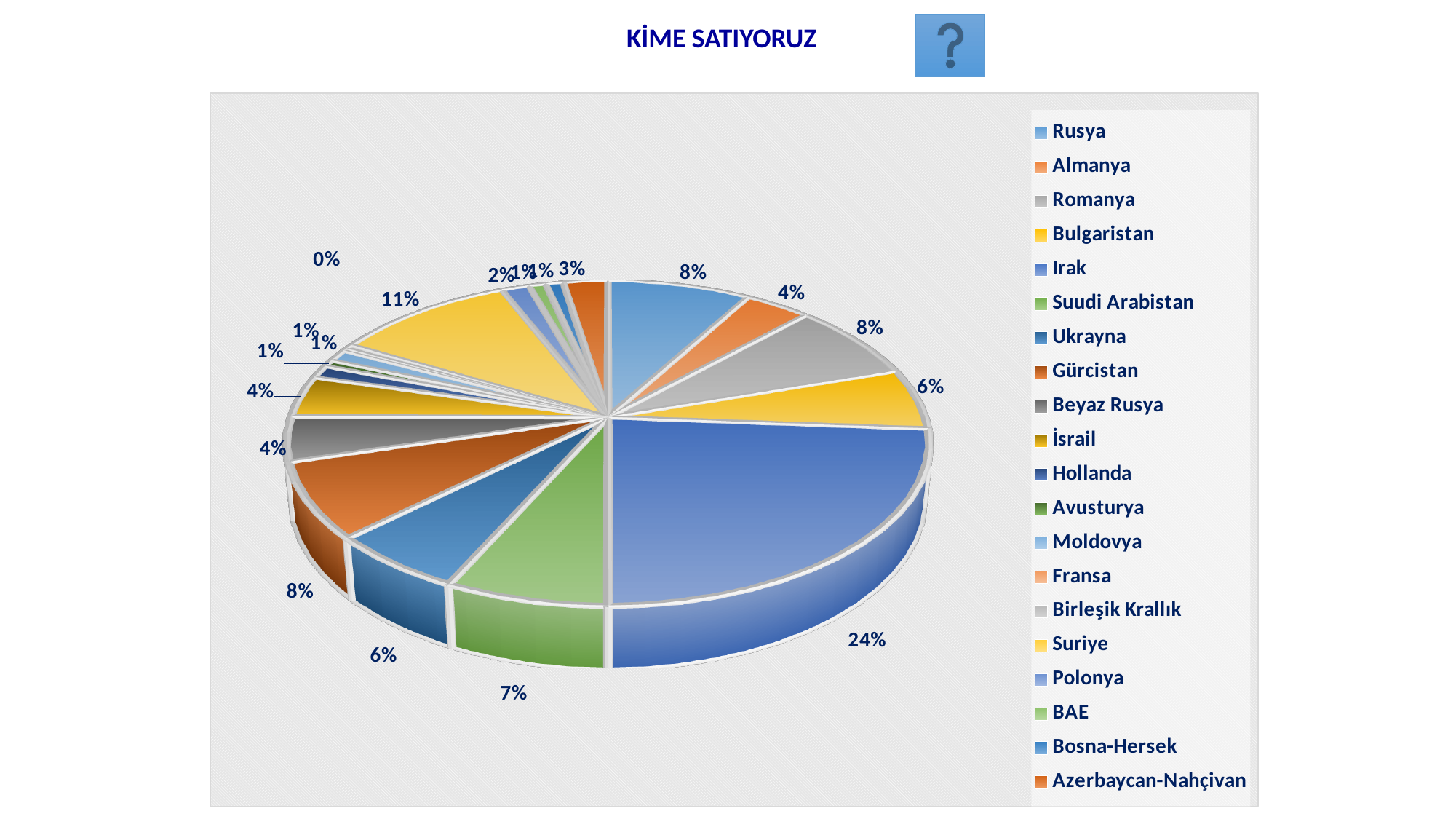
What share of the pie does Suriye have? 11% Which is larger, the share for Irak or the share for Suriye? Irak Which country has the largest share of the pie? Irak What share of the pie does Almanya have? 4% What is the difference between the shares of Irak and Suriye? 13% What is the title of the chart? KİME SATIYORUZ What share of the pie does Azerbaycan-Nahçivan have? 3% How many countries are listed in the chart legend? 20 What type of chart is shown on the slide? pie chart